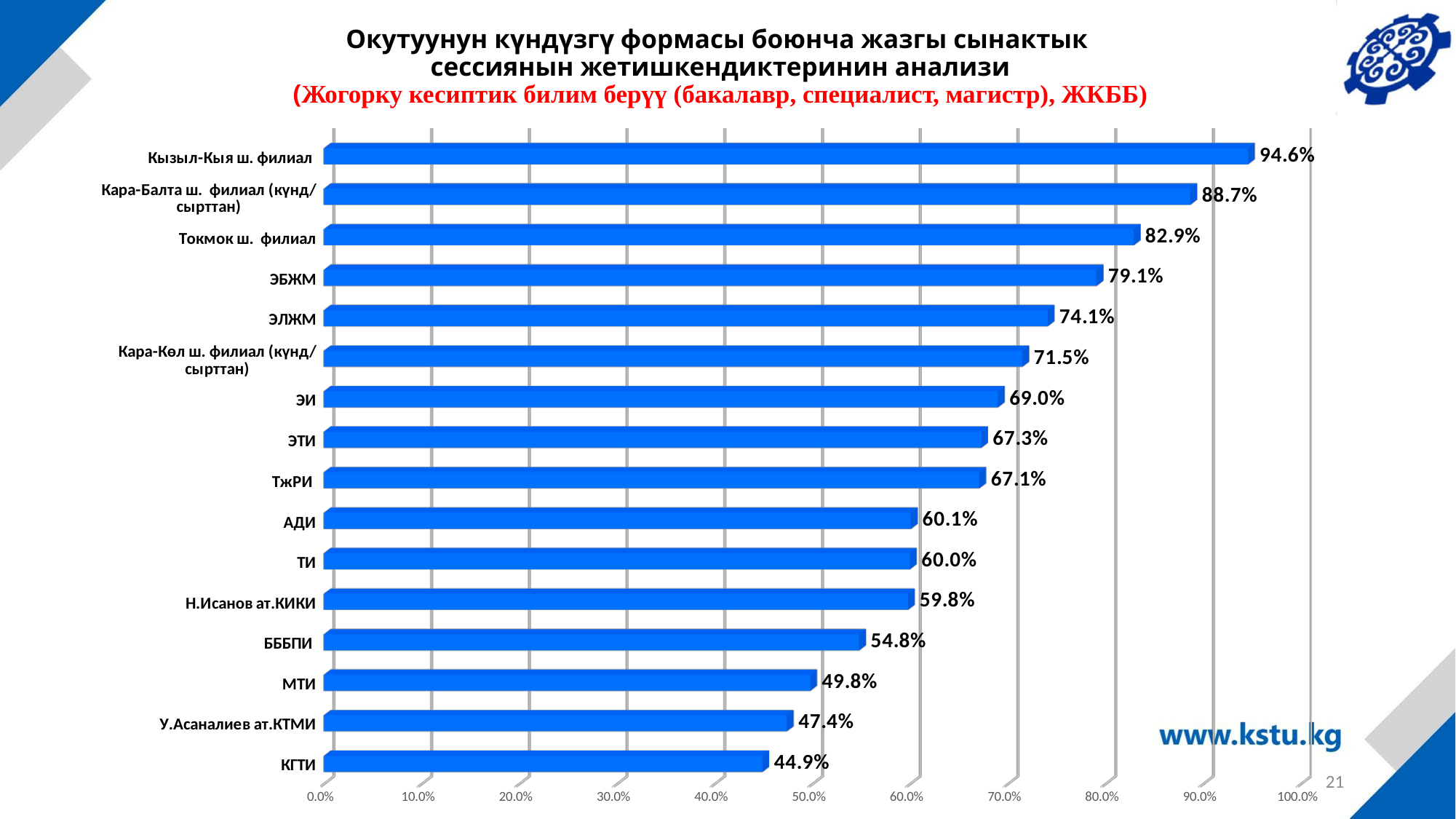
What kind of chart is shown on the slide? Bar chart How many categories are shown in the chart? 16 Do the values rise or fall going from the top bar to the bottom bar? Fall What is the value for Н.Исанов ат.КИКИ? 59.8% Which has a larger value, ЭЛЖМ or БББПИ? ЭЛЖМ What is the value for ЭБЖМ? 79.1% What is the value for Кызыл-Кыя ш. филиал? 94.6% Which category has the highest value? Кызыл-Кыя ш. филиал What is the value for У.Асаналиев ат.КТМИ? 47.4% What is the difference between the values for Токмок ш. филиал and ЭБЖМ? 3.8 percentage points Which category has the lowest value? КГТИ What is the difference between the values for Кызыл-Кыя ш. филиал and КГТИ? 49.7 percentage points